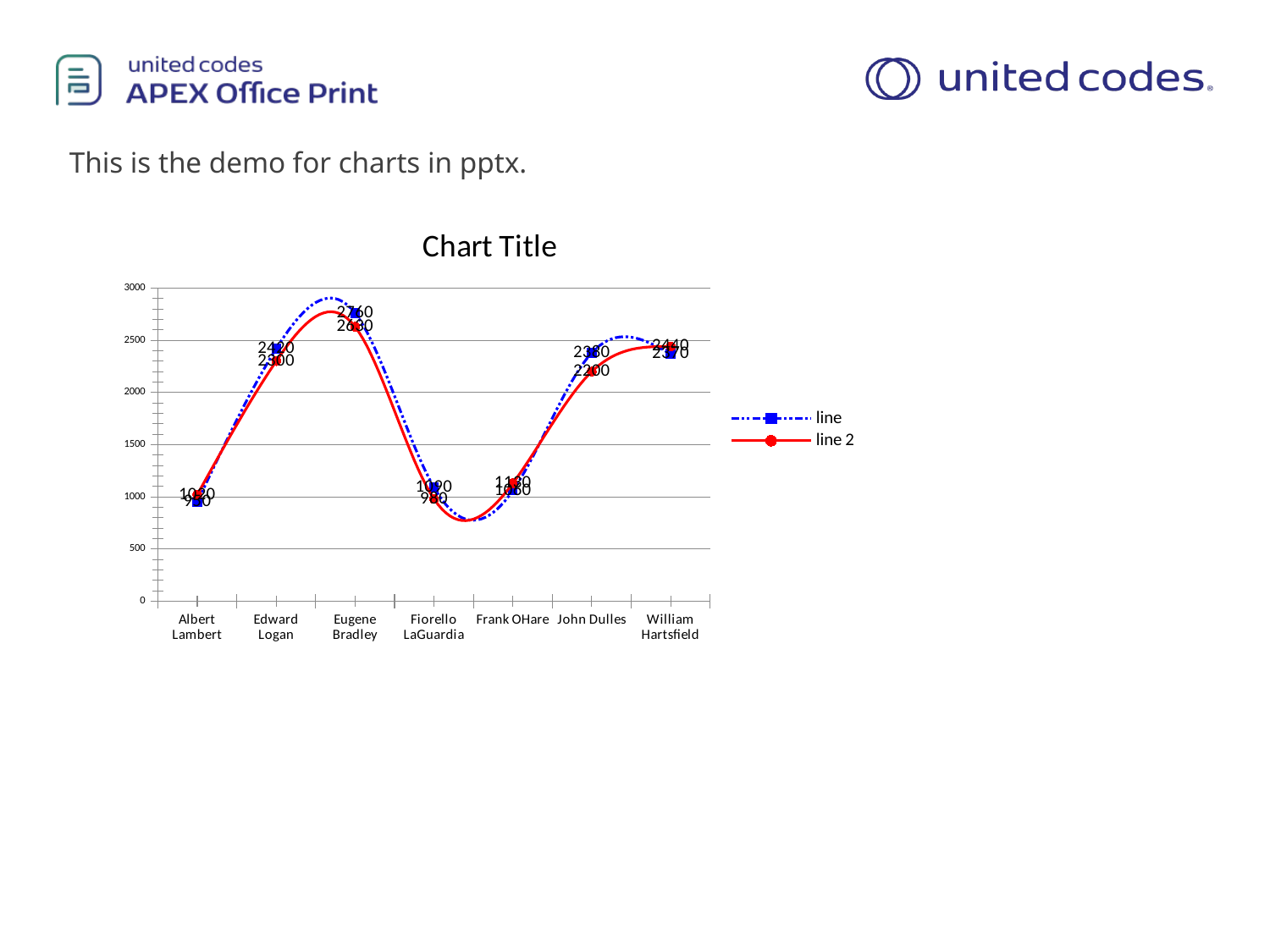
How many series does the legend list? 2 What is the title of the chart? Chart Title How many categories are shown on the x axis? 7 Is the value for John Dulles in the series "line" greater or less than 2000? greater What kind of chart is shown on the slide? line chart Which category has the highest value for the series "line"? Eugene Bradley What are the names of the series in the legend? line, line 2 Is the value for Albert Lambert in the series "line" greater or less than 1500? less Which category has the highest value for the series "line 2"? Eugene Bradley For the series "line 2", which is larger: the value for Edward Logan or the value for Frank OHare? Edward Logan Is the value for Eugene Bradley in the series "line 2" greater or less than 2500? greater Do the values of the series "line" rise or fall from Eugene Bradley to Fiorello LaGuardia? fall